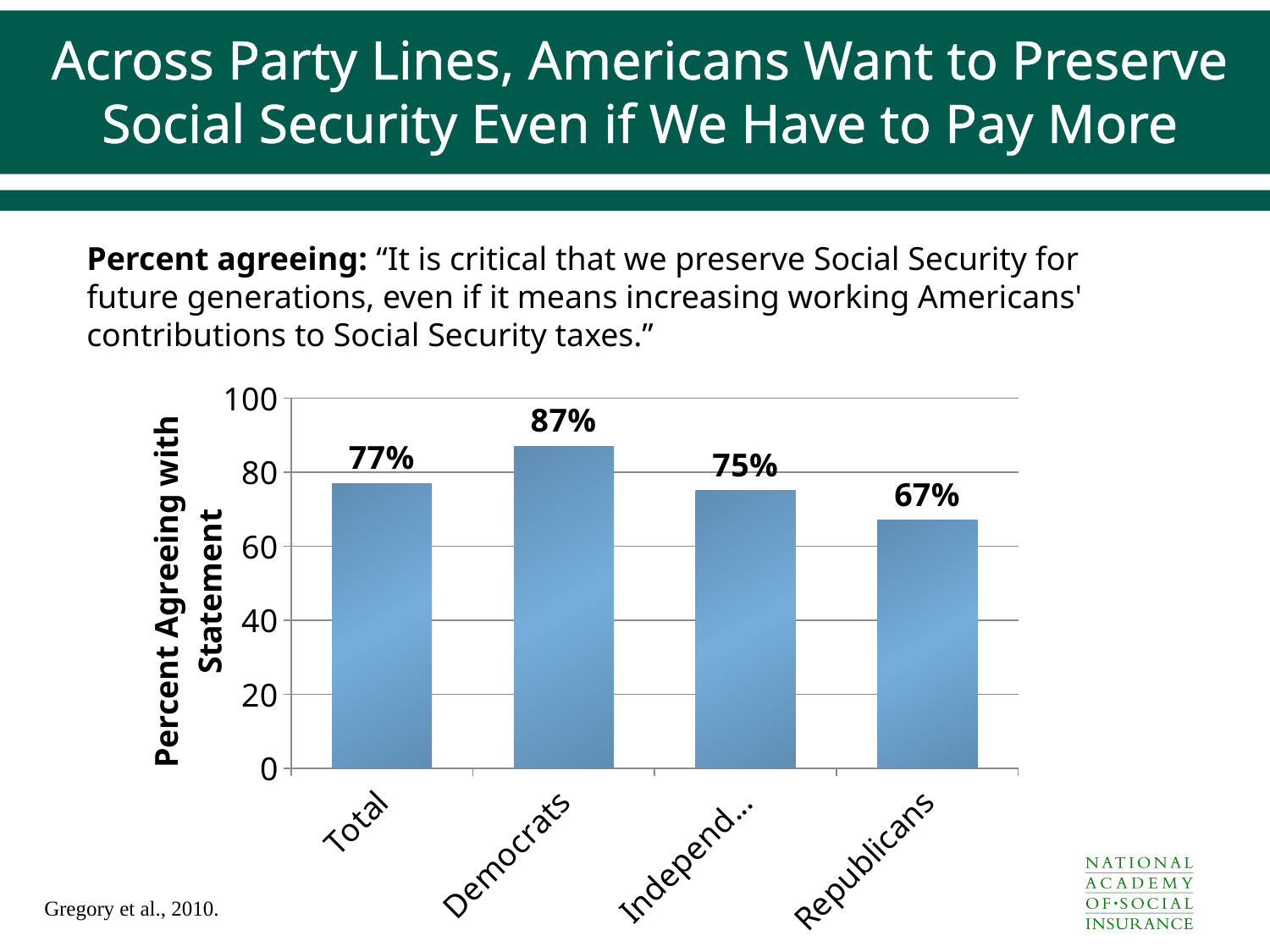
What is the value shown for Republicans? 67% What is the difference between the Total value and the Republicans value? 10 percentage points What is the value shown for the Total category? 77% What is the difference between the values for Democrats and Republicans? 20 percentage points Is the value for Democrats greater or less than 80? greater What is the label on the vertical axis of the chart? Percent Agreeing with Statement What percent of Democrats agree with the statement? 87% Which is larger, the value for Total or the value for Republicans? Total What kind of chart is shown on the slide? Bar chart Which category has the lowest percent agreeing with the statement? Republicans Which category has the highest percent agreeing with the statement? Democrats How many categories are shown on the x axis? 4